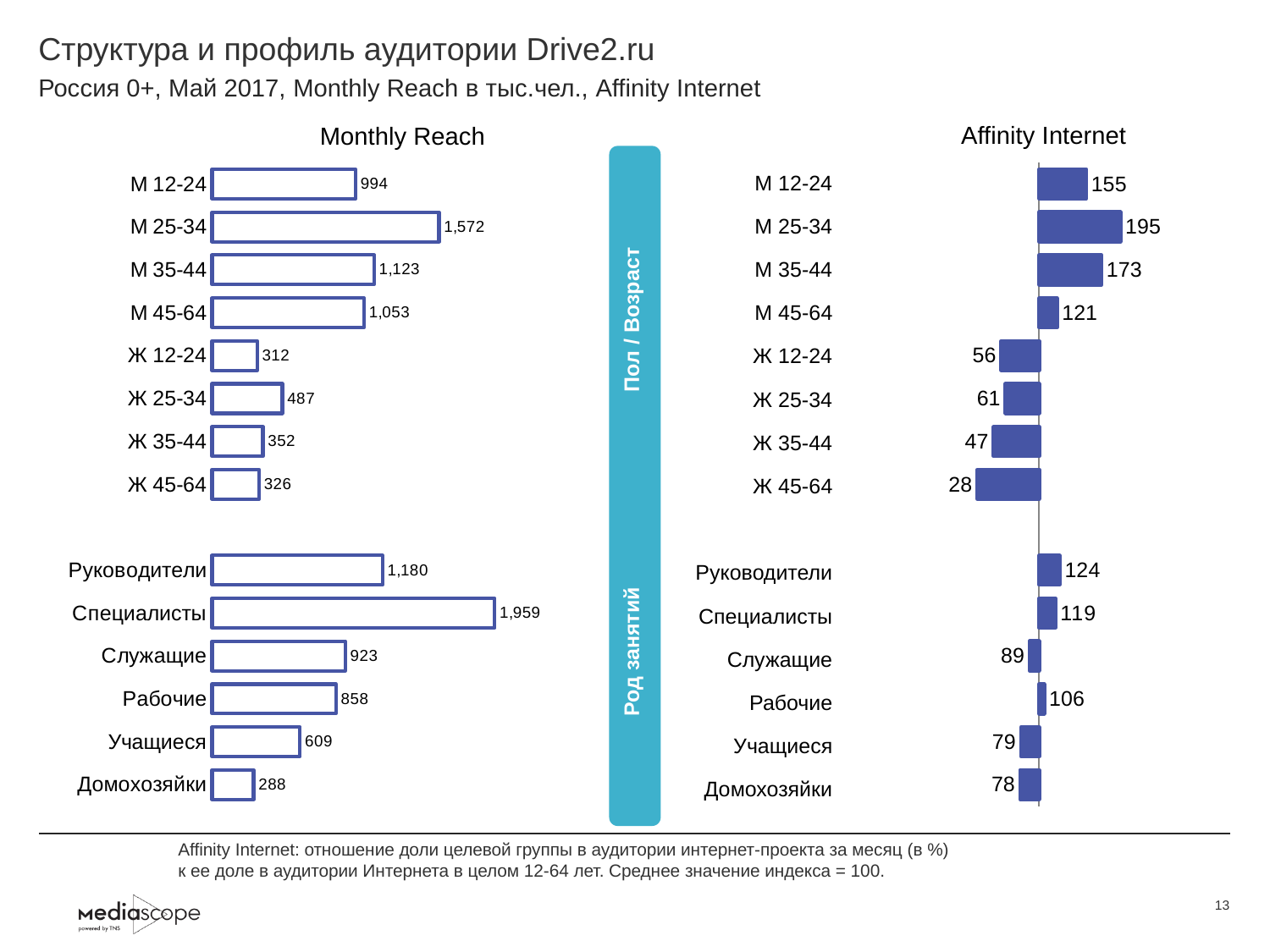
In the Affinity Internet chart, what is the difference between М 25-34 and Ж 25-34? 134 In the Monthly Reach chart, what is the difference between Специалисты and Руководители? 779 In the Affinity Internet chart, which category has the lowest value? Ж 45-64 In the Monthly Reach chart, what is the value for Домохозяйки? 288 In the Affinity Internet chart, which is larger, М 35-44 or М 45-64? М 35-44 In the Affinity Internet chart, which category has the highest value? М 25-34 In the Monthly Reach chart, how many categories are plotted? 14 In the Monthly Reach chart, what is the value for М 25-34? 1,572 What type of chart is the Affinity Internet chart? Bar chart What is the title of the chart on the left side of the slide? Monthly Reach In the Affinity Internet chart, what is the value for Ж 45-64? 28 In the Monthly Reach chart, which category has the highest value? Специалисты